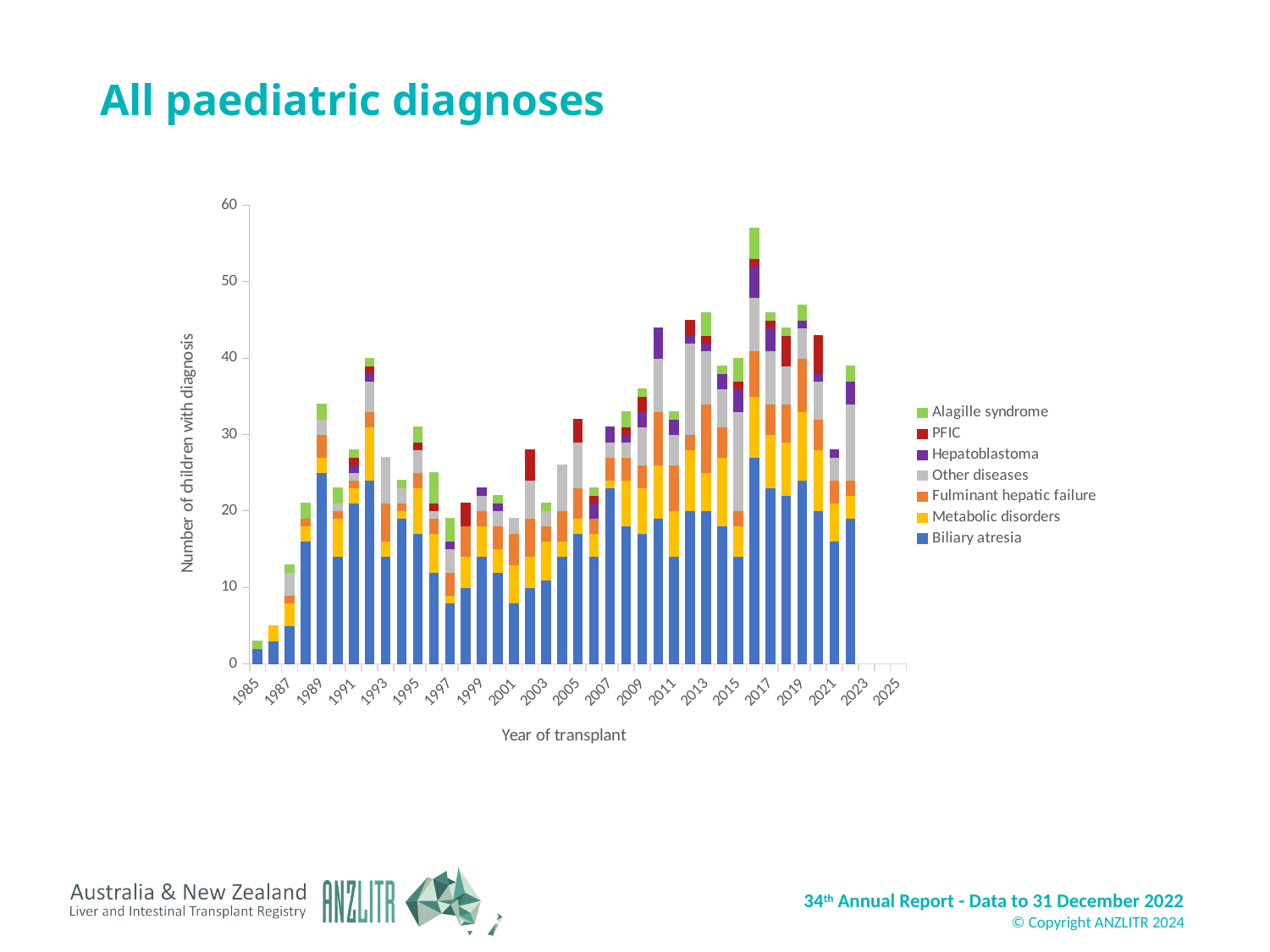
Is the total number of children for 2012 greater or less than 40? greater Which year has a taller stacked bar, 2008 or 2010? 2010 How many series does the legend list? 7 Is the total number of children for 2016 greater or less than 50? greater What is the label of the y axis? Number of children with diagnosis Is the total number of children for 1985 greater or less than 10? less Which year has the tallest stacked bar? 2016 What is the title of the chart? All paediatric diagnoses Which year has a taller stacked bar, 2016 or 2020? 2016 What kind of chart is shown on the slide? Stacked bar chart Which year has the shortest stacked bar? 1985